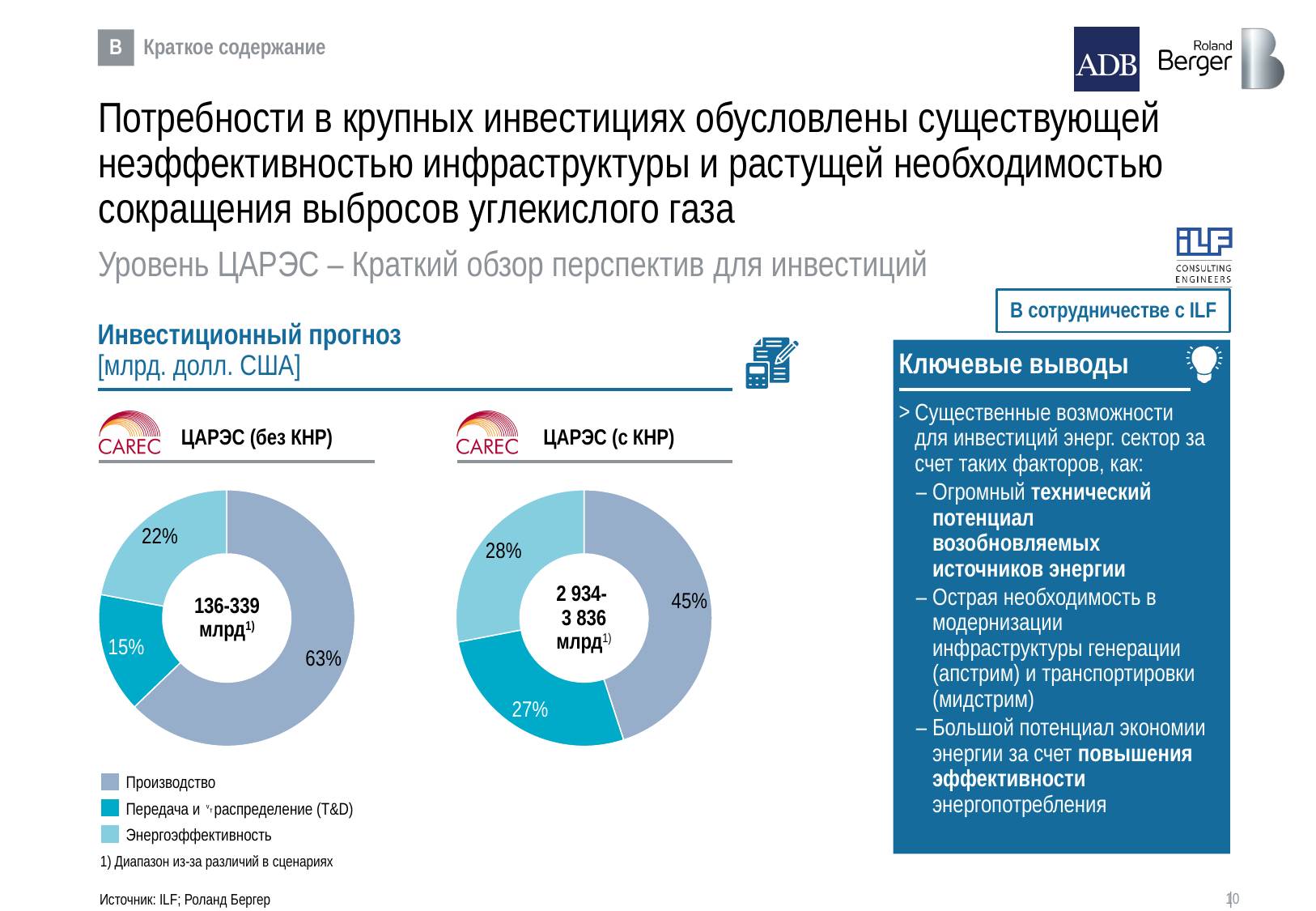
In the ЦАРЭС (с КНР) chart, what is the difference in percentage points between Производство and Передача и распределение (T&D)? 18 In the ЦАРЭС (без КНР) chart, what share does Производство account for? 63% In the ЦАРЭС (с КНР) chart, what share does Передача и распределение (T&D) account for? 27% What total investment range is shown in the centre of the ЦАРЭС (с КНР) chart? 2 934-3 836 млрд In the ЦАРЭС (с КНР) chart, what share does Энергоэффективность account for? 28% Which chart shows a larger share for Производство, ЦАРЭС (без КНР) or ЦАРЭС (с КНР)? ЦАРЭС (без КНР) In the ЦАРЭС (с КНР) chart, which category has the largest share? Производство In the ЦАРЭС (без КНР) chart, what share does Энергоэффективность account for? 22% How many categories does the legend list for the investment forecast charts? 3 In the ЦАРЭС (без КНР) chart, which category has the smallest share? Передача и распределение (T&D) In the ЦАРЭС (без КНР) chart, what is the difference in percentage points between Производство and Энергоэффективность? 41 What type of chart is used for ЦАРЭС (без КНР) and ЦАРЭС (с КНР)? Pie (donut) chart